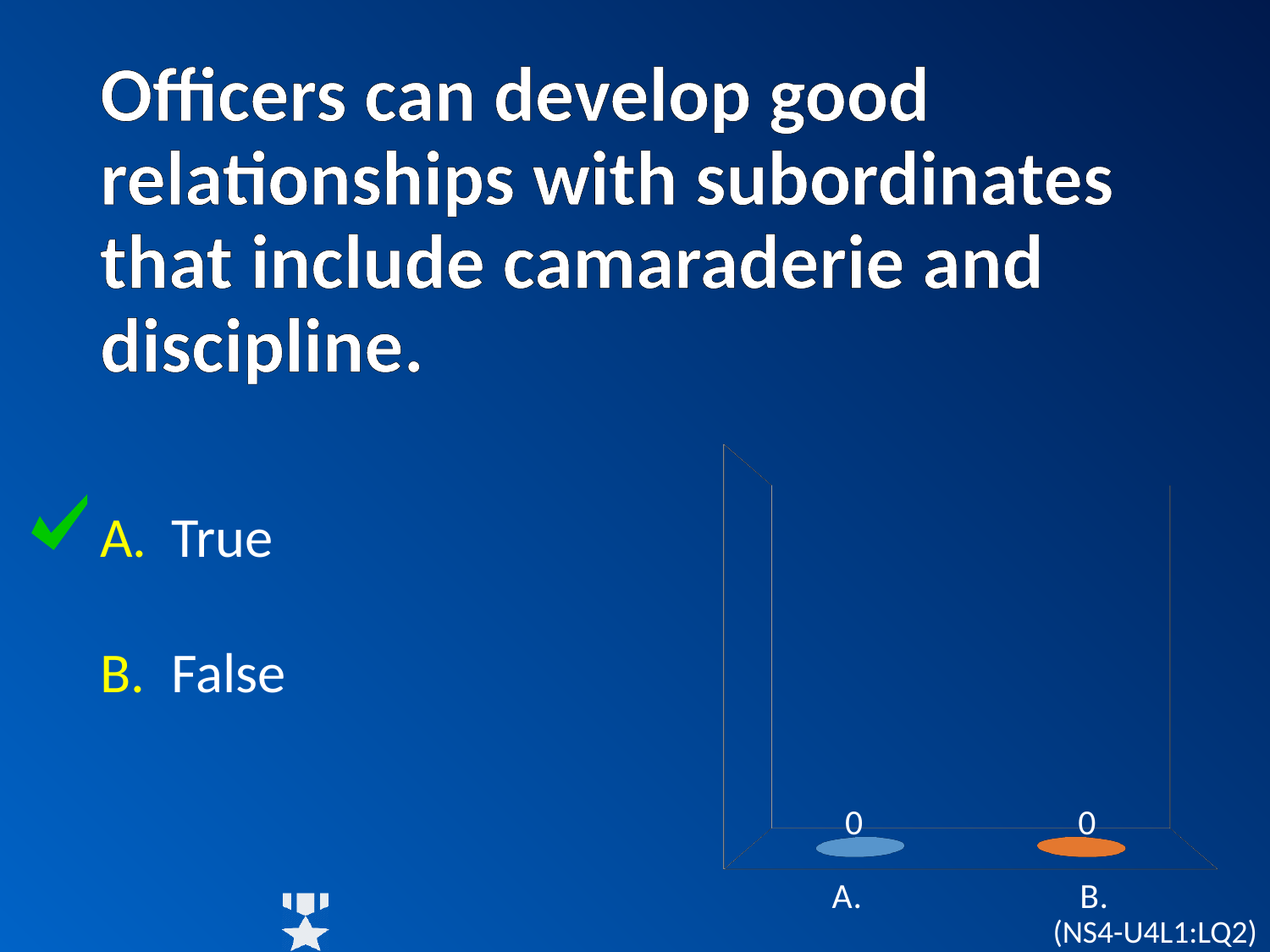
What colour is the bar for category B. in the chart? orange What is the difference between the values for A. and B. in the chart? 0 Are the values for A. and B. in the chart equal? yes What kind of chart is shown on the slide? bar chart What is the value shown for category A. in the chart? 0 How many categories are plotted in the chart? 2 What are the category labels on the x axis of the chart? A. and B. What is the value shown for category B. in the chart? 0